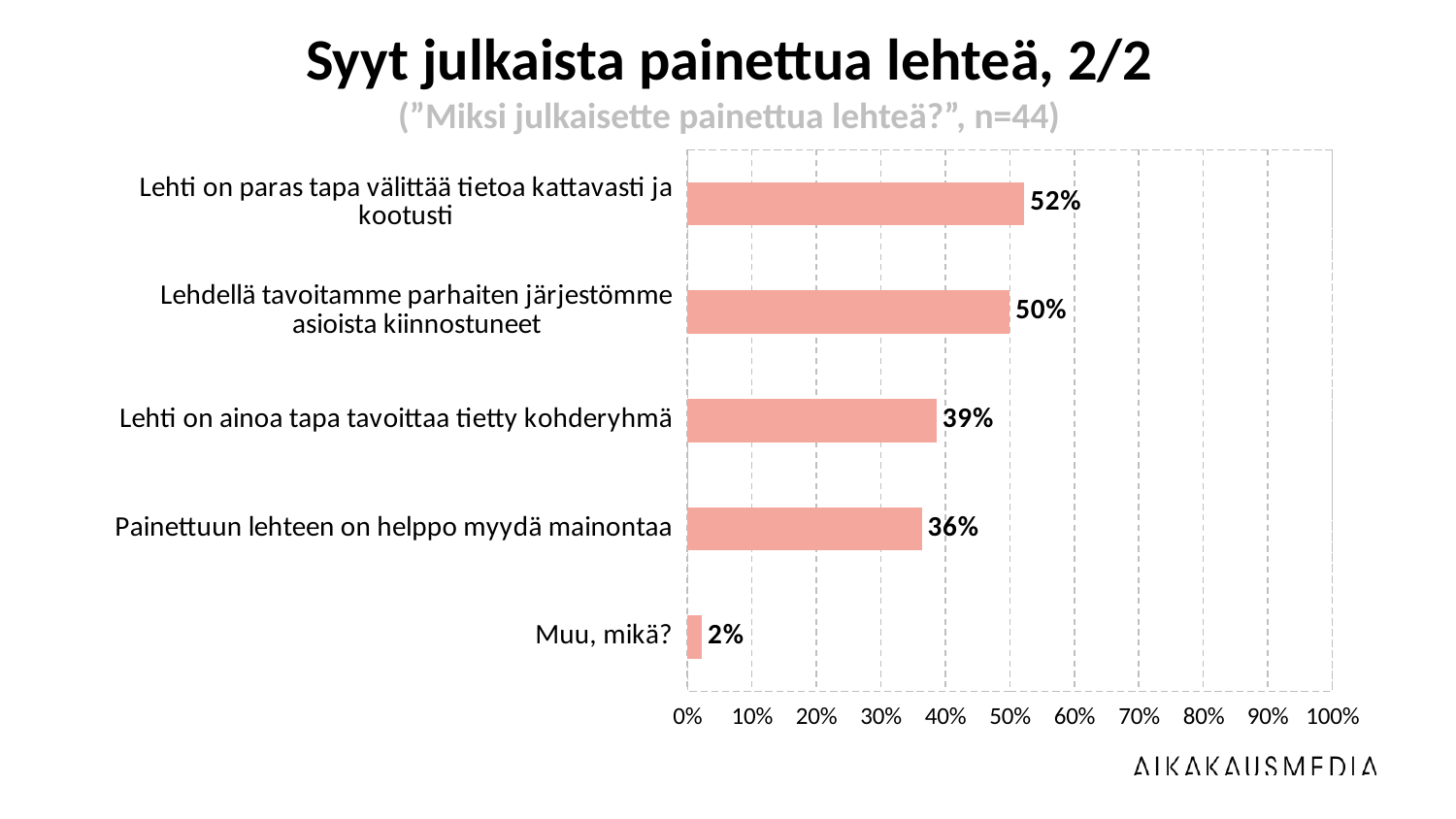
What is the value for "Muu, mikä?"? 2% Which category has the highest value? Lehti on paras tapa välittää tietoa kattavasti ja kootusti What is the difference between the values for "Lehti on ainoa tapa tavoittaa tietty kohderyhmä" and "Painettuun lehteen on helppo myydä mainontaa"? 3% What is the title of the chart? Syyt julkaista painettua lehteä, 2/2 What is the value for "Lehti on ainoa tapa tavoittaa tietty kohderyhmä"? 39% What kind of chart is shown on the slide? Bar chart What is the value for "Painettuun lehteen on helppo myydä mainontaa"? 36% What is the value for "Lehdellä tavoitamme parhaiten järjestömme asioista kiinnostuneet"? 50% Which category has the lowest value? Muu, mikä? How many categories are shown in the chart? 5 What is the value for "Lehti on paras tapa välittää tietoa kattavasti ja kootusti"? 52% Which is larger: the value for "Lehti on paras tapa välittää tietoa kattavasti ja kootusti" or the value for "Lehti on ainoa tapa tavoittaa tietty kohderyhmä"? Lehti on paras tapa välittää tietoa kattavasti ja kootusti